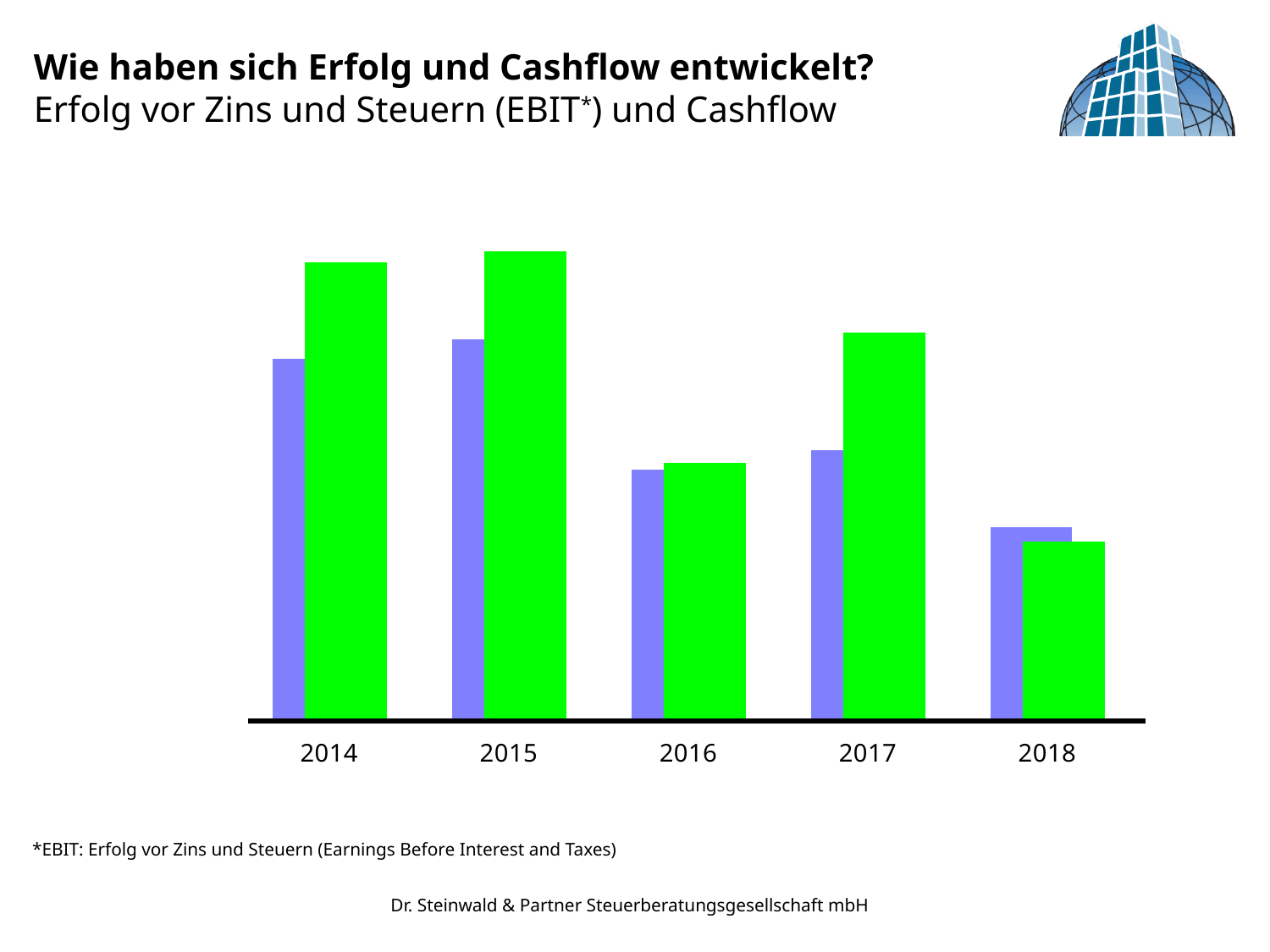
In 2017, which bar is taller, the blue one or the green one? green Which year has the shortest blue bar? 2018 Which year has the tallest green bar? 2015 How many years are shown on the x axis of the chart? 5 Which year has the shortest green bar? 2018 In 2018, which bar is taller, the blue one or the green one? blue What is the first year shown on the x axis of the chart? 2014 Do the green bars rise or fall from 2017 to 2018? fall Which year has the tallest blue bar? 2015 Is the green bar for 2015 taller or shorter than the green bar for 2017? taller What kind of chart is shown on the slide? bar chart